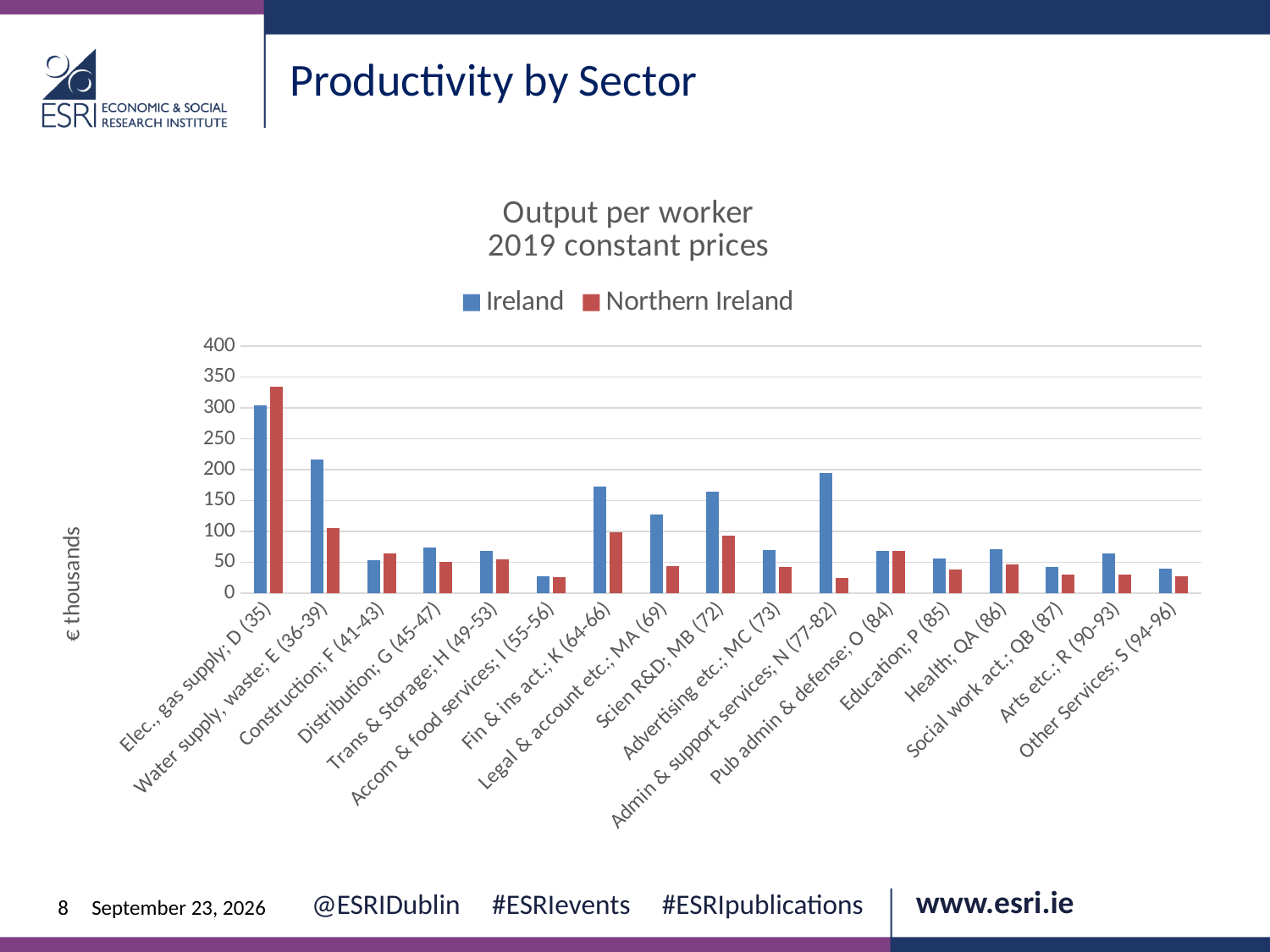
What kind of chart is shown on the slide? bar chart Is the Northern Ireland value for Admin & support services; N (77-82) greater or less than 50? less Is the Ireland value for Fin & ins act.; K (64-66) greater or less than 150? greater Is the Ireland value for Water supply, waste; E (36-39) greater or less than 200? greater How many series does the legend list? 2 How many sector categories are shown on the x axis? 17 Which sector has the lowest Ireland value? Accom & food services; I (55-56) Which sector has the highest Ireland value? Elec., gas supply; D (35) What unit is given on the vertical axis label? € thousands For Water supply, waste; E (36-39), which is larger: Ireland or Northern Ireland? Ireland For Elec., gas supply; D (35), which is larger: Ireland or Northern Ireland? Northern Ireland Which sector has the highest Northern Ireland value? Elec., gas supply; D (35)